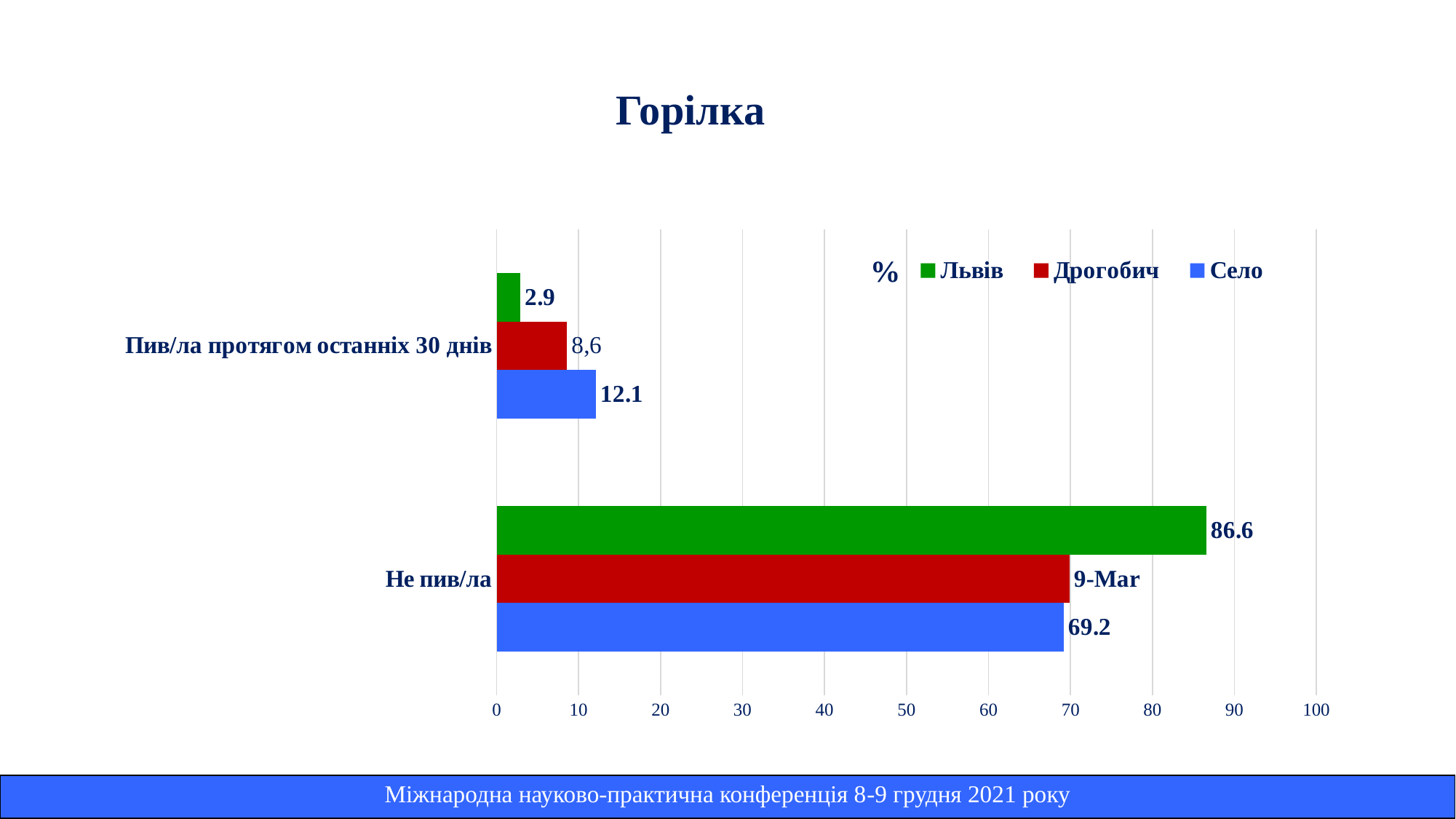
How many categories are shown on the vertical axis? 2 Which series has the lowest value in the category "Пив/ла протягом останніх 30 днів"? Львів Is the value for Дрогобич in the category "Не пив/ла" greater or less than 60? greater How many series does the legend list? 3 Which colour represents the Село series in the legend? blue What is the value for Дрогобич in the category "Пив/ла протягом останніх 30 днів"? 8,6 What is the difference between the Село and Львів values in the category "Пив/ла протягом останніх 30 днів"? 9.2 What type of chart is shown on the slide? bar chart What is the title of the chart? Горілка What is the value for Село in the category "Не пив/ла"? 69.2 What is the value for Львів in the category "Пив/ла протягом останніх 30 днів"? 2.9 Which series has the highest value in the category "Не пив/ла"? Львів